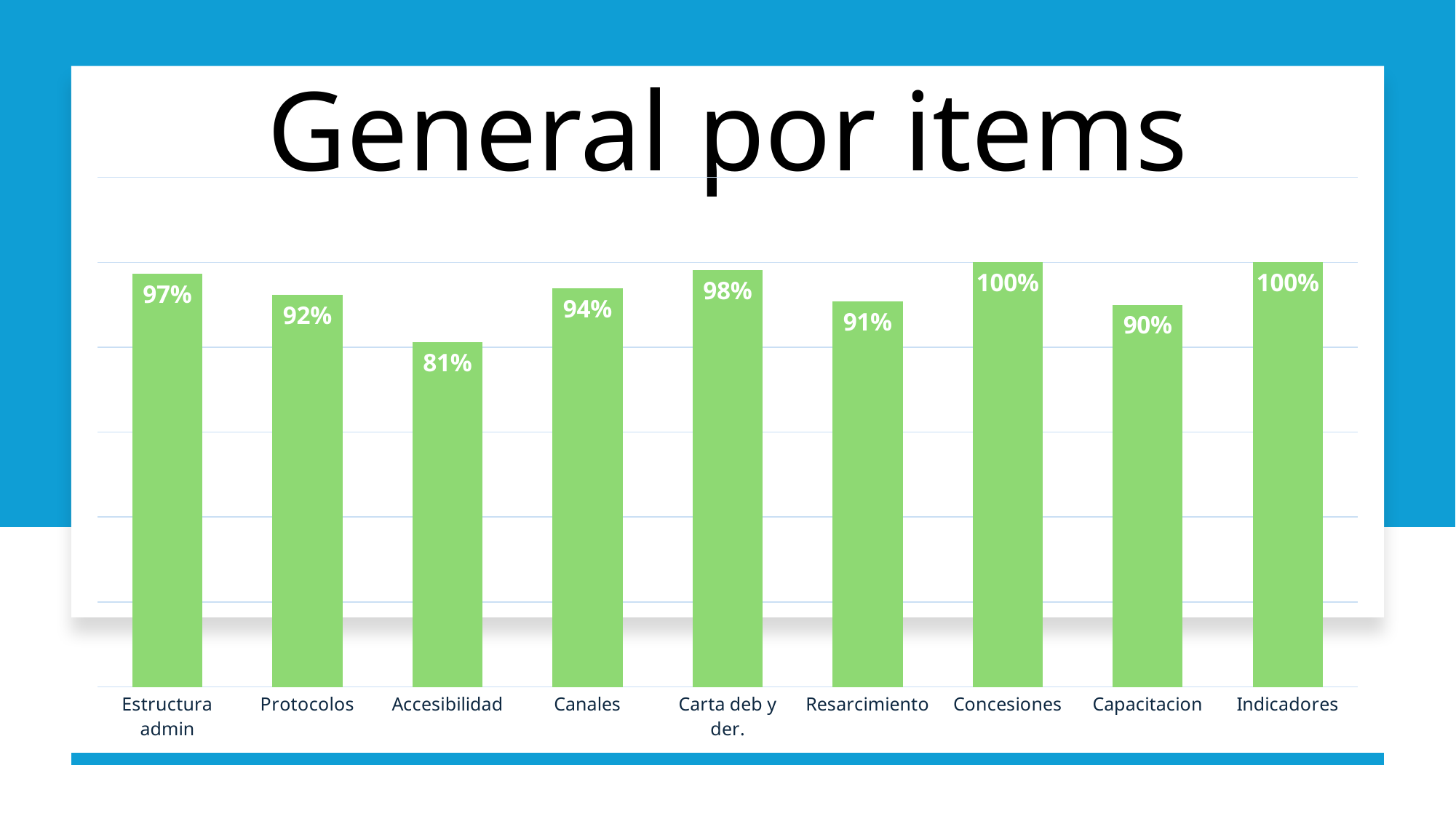
What is the difference between the values for Canales and Accesibilidad? 13% What is the title of the chart? General por items What is the difference between the values for Estructura admin and Protocolos? 5% What is the value for Carta deb y der.? 98% What is the value for Estructura admin? 97% What kind of chart is shown on the slide? Bar chart Which category has the lowest value? Accesibilidad How many categories are shown in the chart? 9 What is the value for Accesibilidad? 81% Which categories share the highest value of 100%? Concesiones and Indicadores What is the value for Capacitacion? 90% Which is larger, the value for Resarcimiento or the value for Canales? Canales